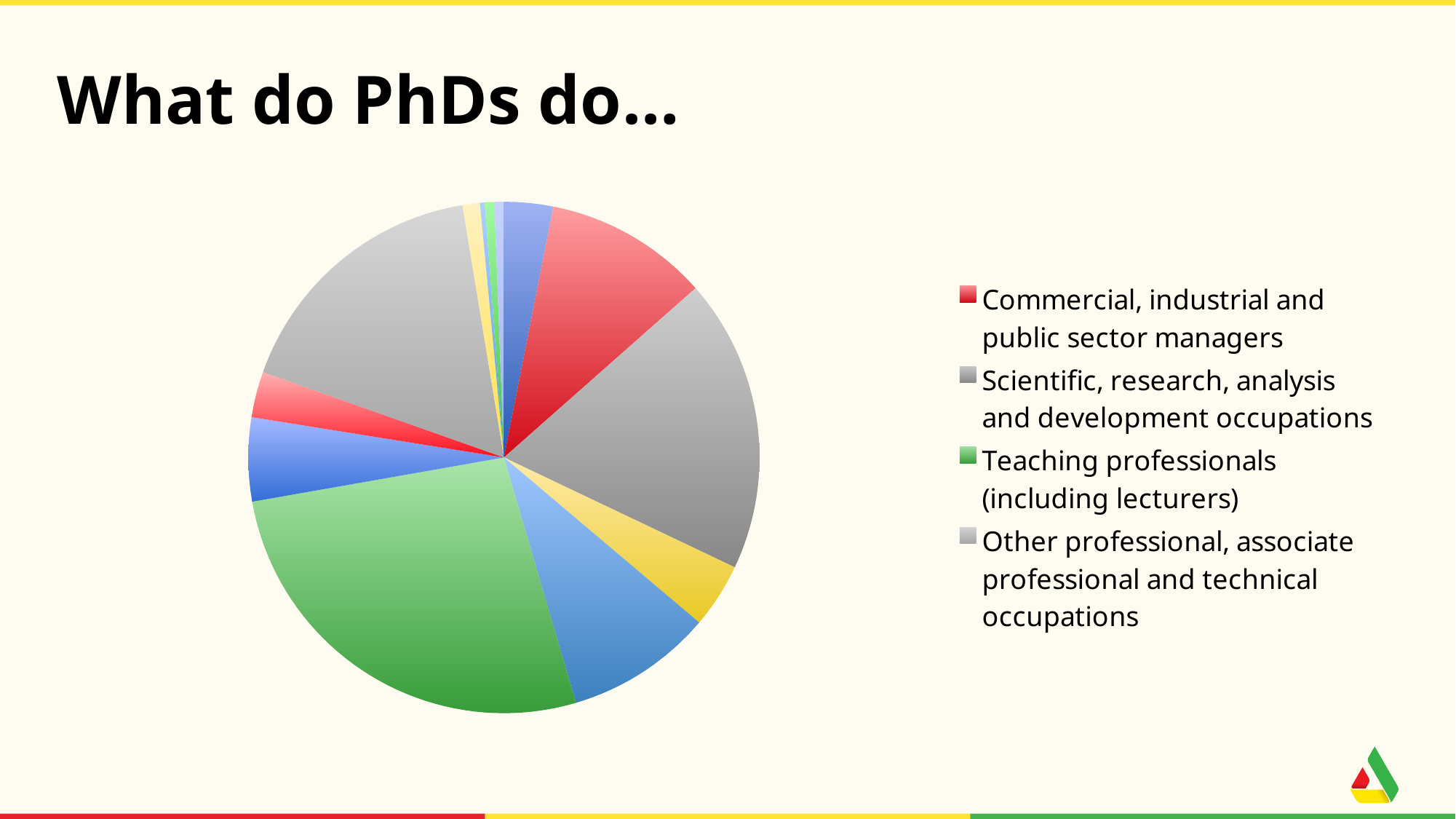
Which legend category has the largest slice in the pie chart? Teaching professionals (including lecturers) How many entries does the legend of the pie chart list? 4 What colour is used for Teaching professionals (including lecturers) in the pie chart? green What kind of chart is shown on the slide? pie chart Which slice is larger in the pie chart: Teaching professionals (including lecturers) or Commercial, industrial and public sector managers? Teaching professionals (including lecturers) What is the title of the slide containing the pie chart? What do PhDs do… Which slice is larger in the pie chart: Scientific, research, analysis and development occupations or Commercial, industrial and public sector managers? Scientific, research, analysis and development occupations